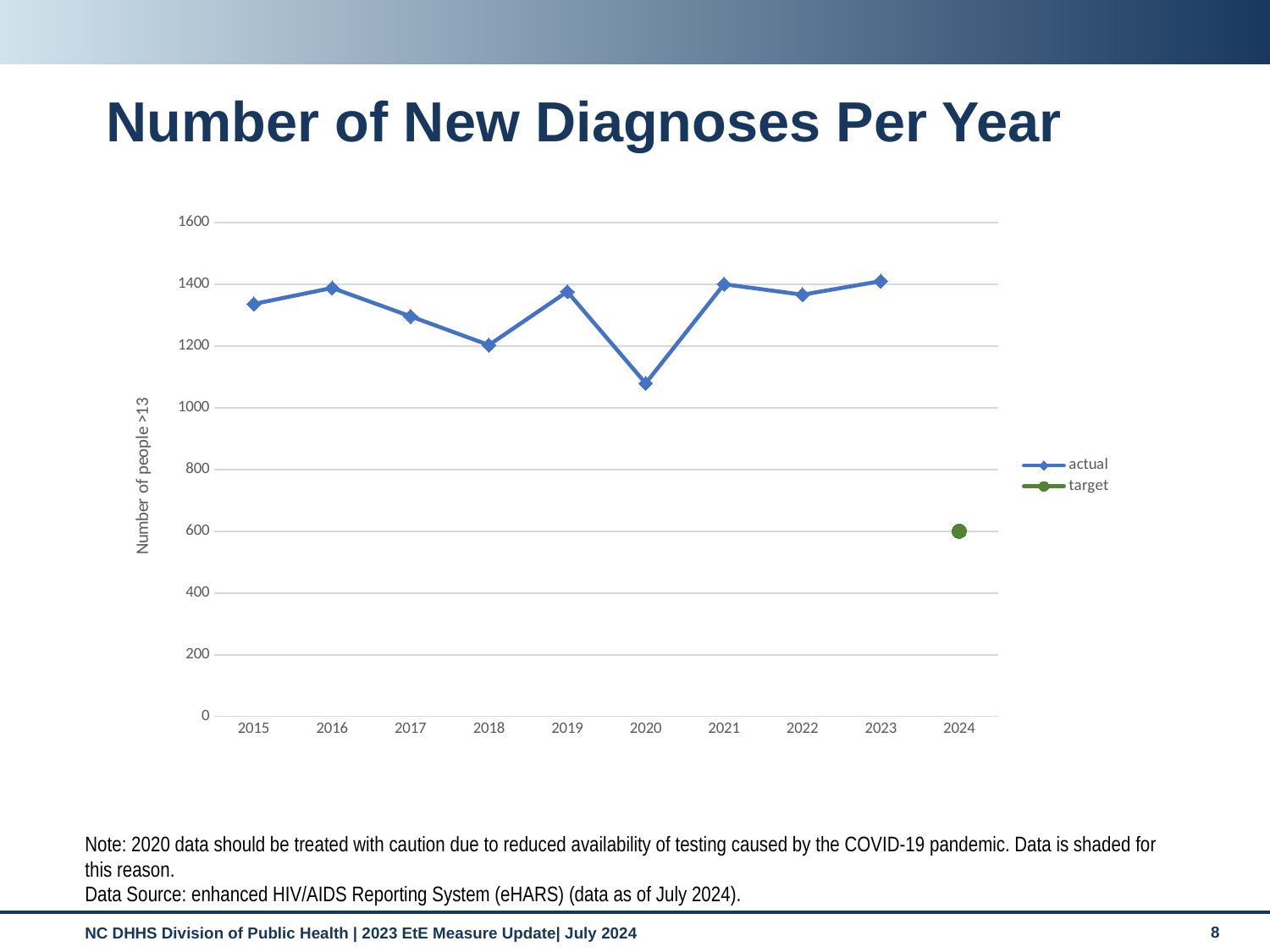
How many series does the legend list? 2 Which year has the larger actual value, 2019 or 2020? 2019 Do the actual values rise or fall from 2019 to 2020? fall Is the actual value for 2015 greater or less than 1200? greater How many years are shown on the x axis? 10 Which year has the larger actual value, 2016 or 2017? 2016 What is the target value shown for 2024? 600 Is the actual value for 2021 greater or less than 1200? greater Which year has the lowest actual number of new diagnoses? 2020 Is the actual value for 2020 greater or less than 1200? less What kind of chart is shown on the slide? line chart What is the label on the y axis? Number of people >13